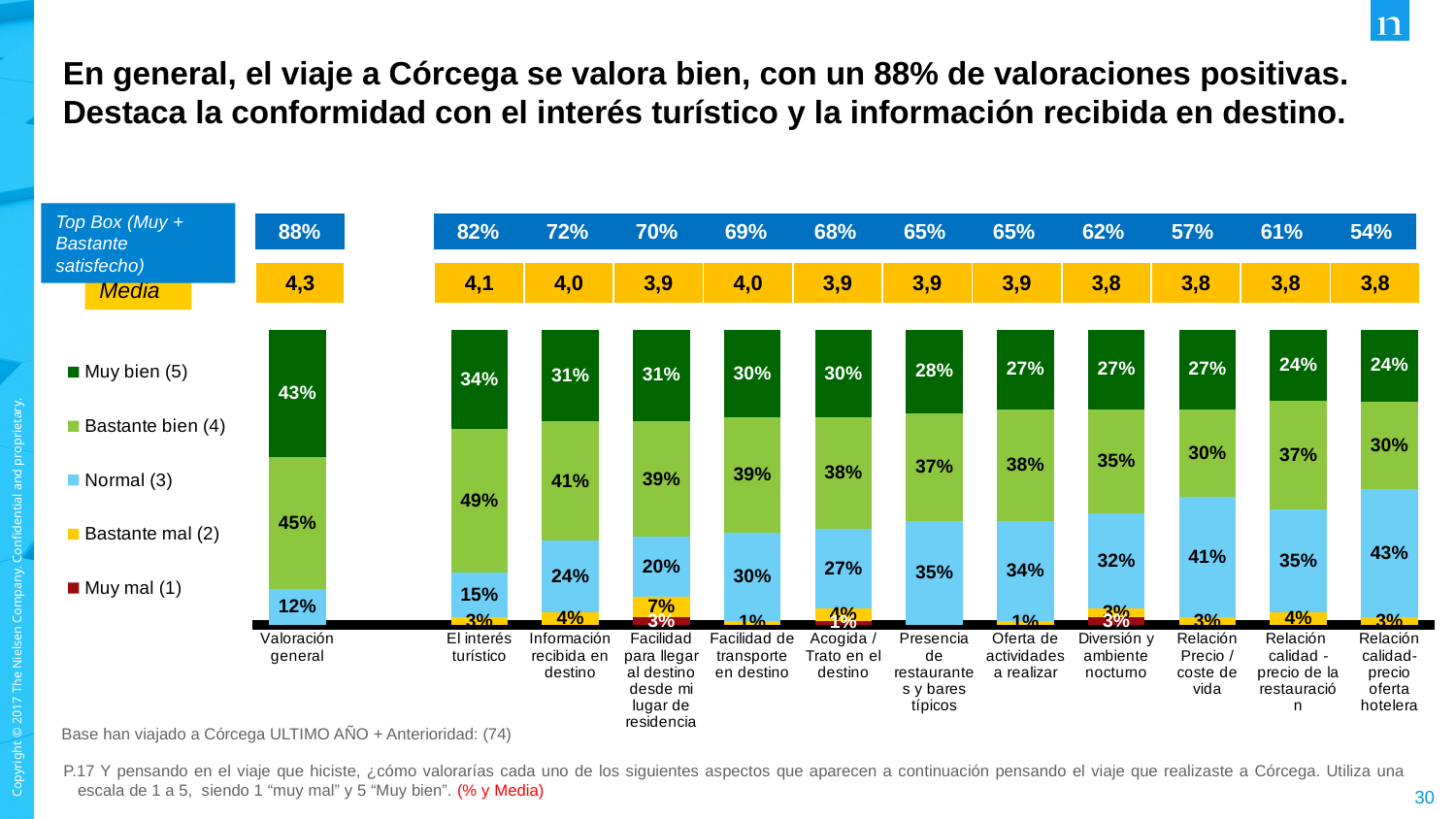
Which category has the highest 'Muy bien (5)' value? Valoración general How many series does the legend list? 5 How many categories are plotted along the x axis? 12 What is the 'Media' value shown for 'Valoración general'? 4,3 What is the 'Muy bien (5)' value for 'Valoración general'? 43% What is the Top Box (Muy + Bastante satisfecho) value shown for 'Información recibida en destino'? 72% What is the 'Normal (3)' value for 'Relación calidad-precio oferta hotelera'? 43% Which is larger: the 'Normal (3)' value for 'Relación Precio / coste de vida' or for 'Diversión y ambiente nocturno'? Relación Precio / coste de vida What is the difference between the 'Muy bien (5)' values for 'Valoración general' and 'El interés turístico'? 9% What is the 'Bastante bien (4)' value for 'El interés turístico'? 49% Which category has the lowest 'Normal (3)' value? Valoración general What kind of chart is shown on the slide? Stacked bar chart